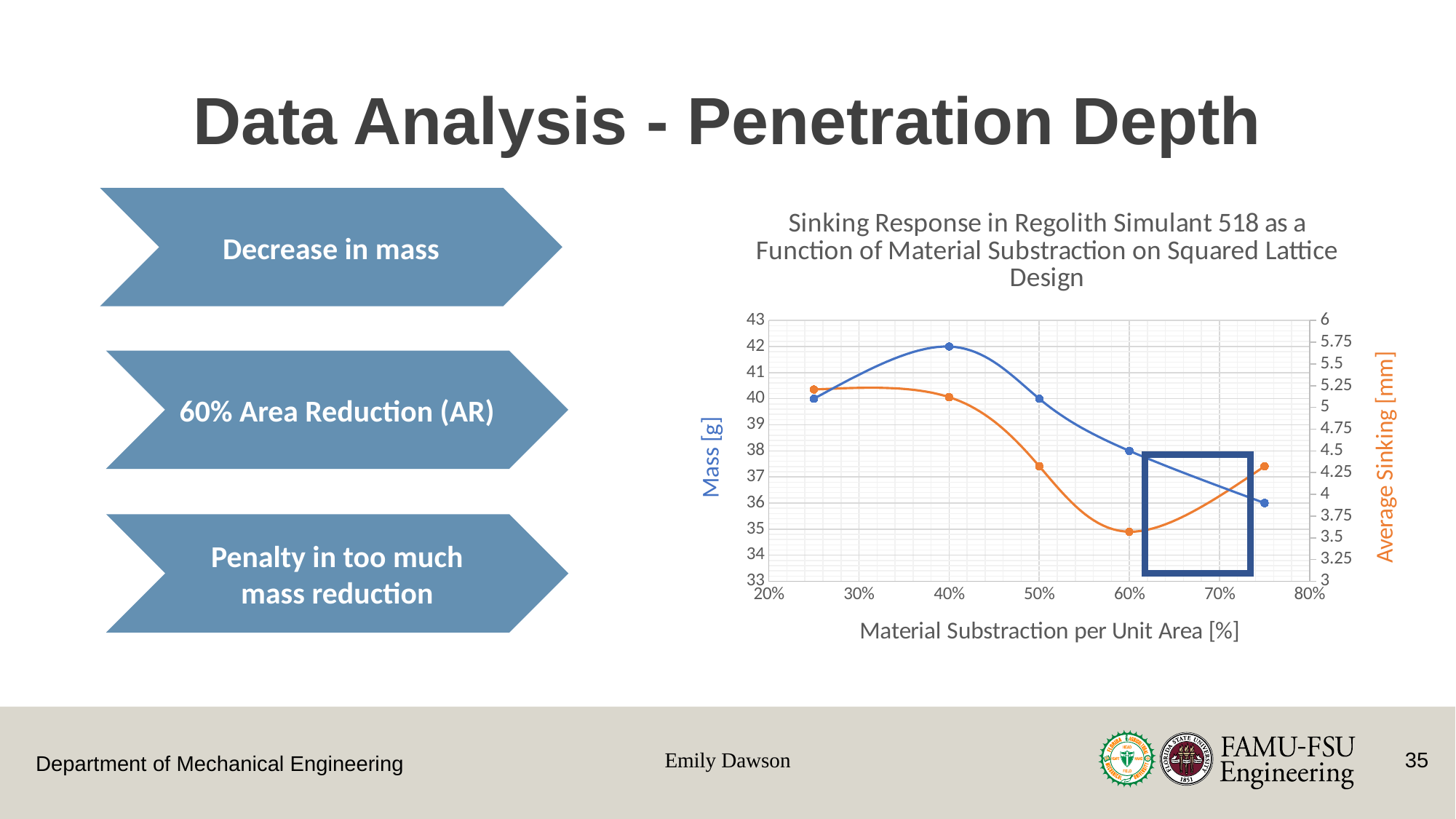
Is the Average Sinking value at 60% material substraction greater or less than 4? less How many data points are plotted for the Mass series? 5 What is the difference in Mass between 40% and 75% material substraction? 6 At which material substraction percentage is Average Sinking lowest? 60% What kind of chart is shown on the slide? line chart What is the title of the chart? Sinking Response in Regolith Simulant 518 as a Function of Material Substraction on Squared Lattice Design What is the label of the x axis of the chart? Material Substraction per Unit Area [%] At which material substraction percentage is Mass highest? 40% What is the Mass value at 40% material substraction? 42 Does Mass rise or fall as material substraction increases from 40% to 75%? fall What is the Mass value at 75% material substraction? 36 At which material substraction percentage is Mass lowest? 75%